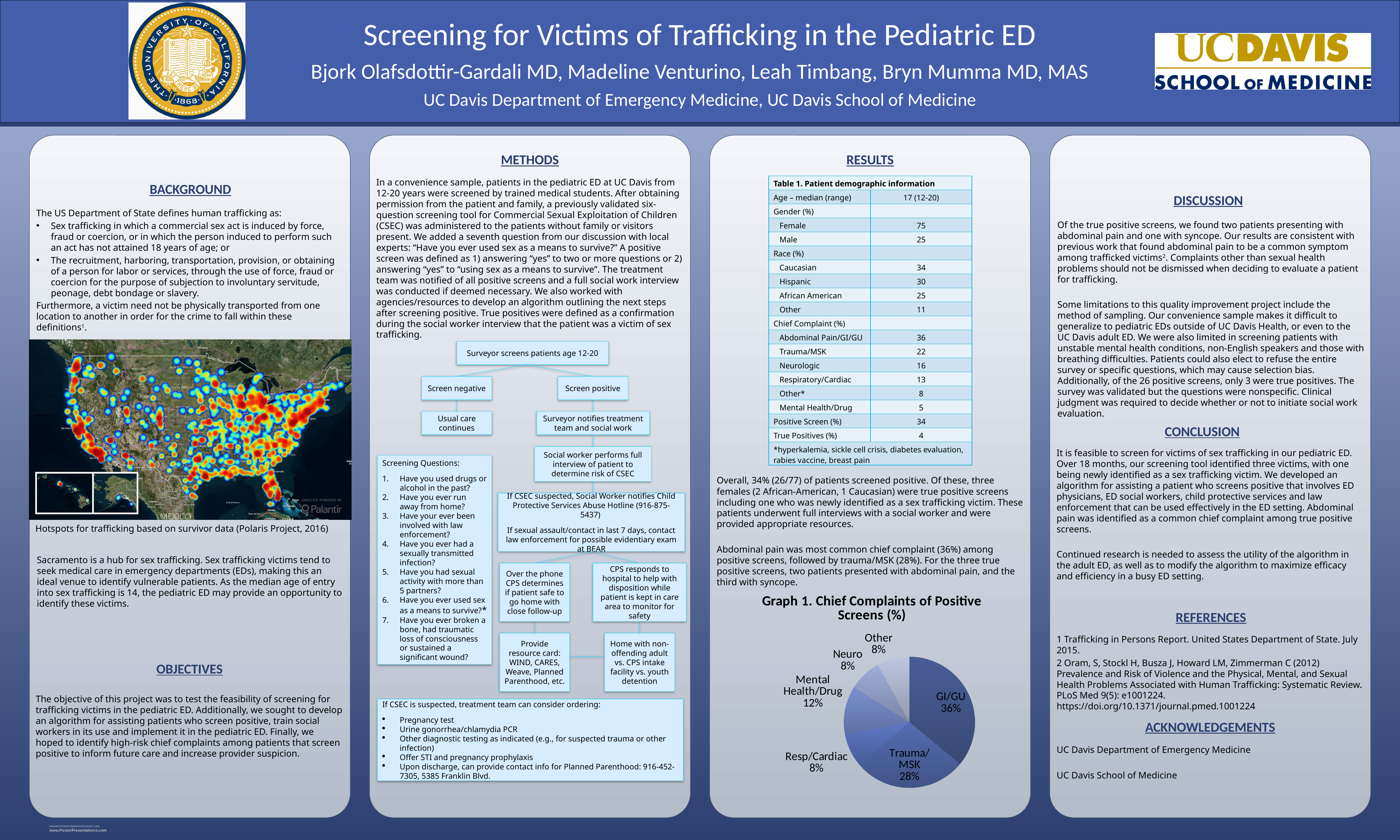
What kind of chart is Graph 1. Chief Complaints of Positive Screens (%)? pie chart In Graph 1, what percentage is shown for Resp/Cardiac? 8% In Graph 1, which chief complaint has the largest slice? GI/GU In Graph 1, what percentage is shown for Trauma/MSK? 28% In Graph 1, which is larger, Mental Health/Drug or Neuro? Mental Health/Drug In Graph 1, what is the combined percentage of GI/GU and Trauma/MSK? 64% In Graph 1, how many slices does the pie chart have? 6 What is the title of the pie chart on the slide? Graph 1. Chief Complaints of Positive Screens (%) In Graph 1, what is the difference in percentage points between Trauma/MSK and Mental Health/Drug? 16 In Graph 1, what is the difference in percentage points between GI/GU and Trauma/MSK? 8 In Graph 1, what percentage is shown for Mental Health/Drug? 12% In Graph 1, what percentage of positive screens had a chief complaint of GI/GU? 36%